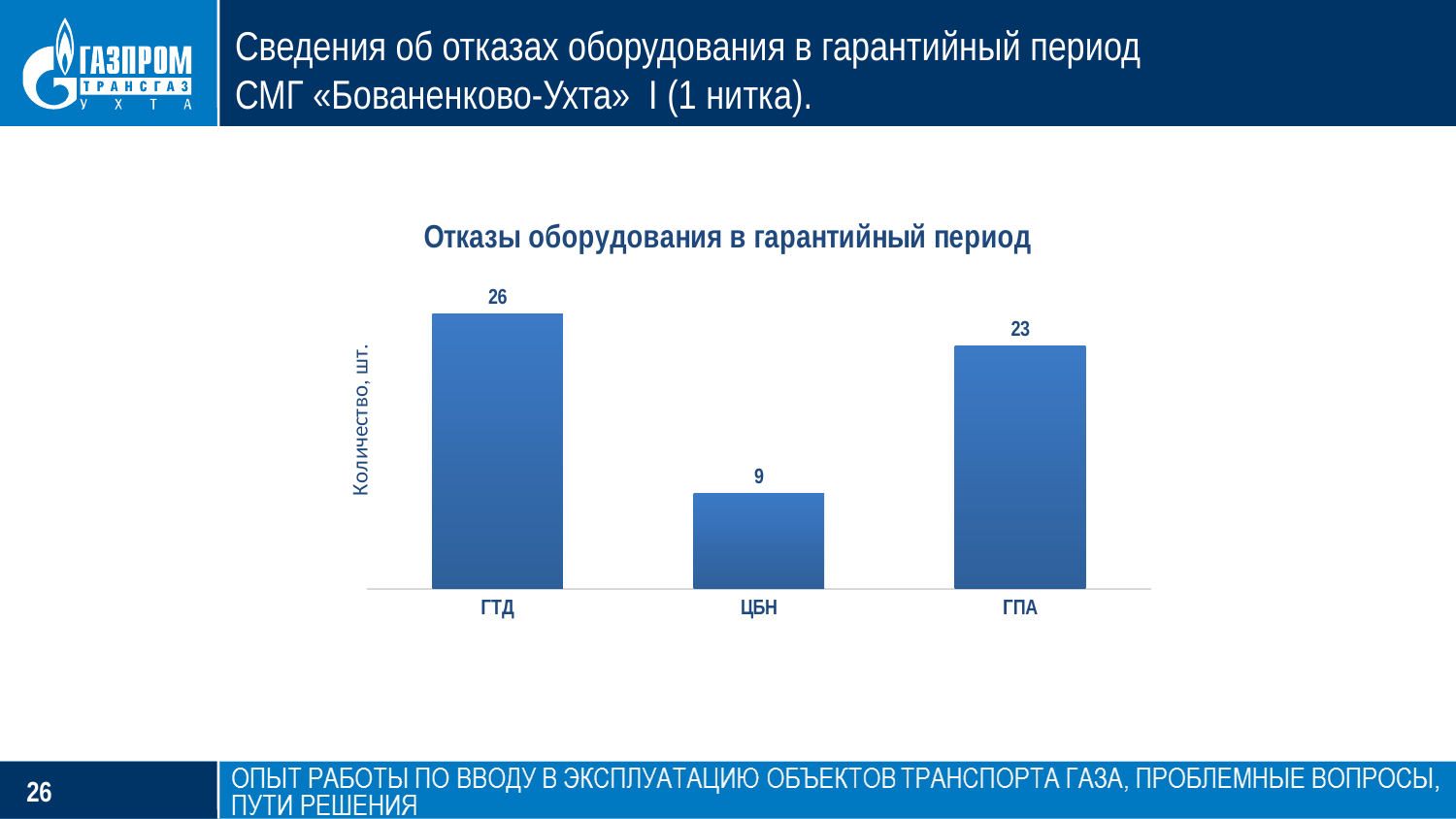
What is the label of the vertical axis? Количество, шт. What is the value for ГПА? 23 How many categories are shown on the x axis? 3 What is the difference between the values for ГТД and ГПА? 3 What is the value for ГТД? 26 What is the value for ЦБН? 9 Which category has the lowest value? ЦБН Which is larger, the value for ГТД or the value for ЦБН? ГТД What is the title of the chart? Отказы оборудования в гарантийный период What is the difference between the values for ГПА and ЦБН? 14 What kind of chart is shown on the slide? bar chart Which category has the highest value? ГТД